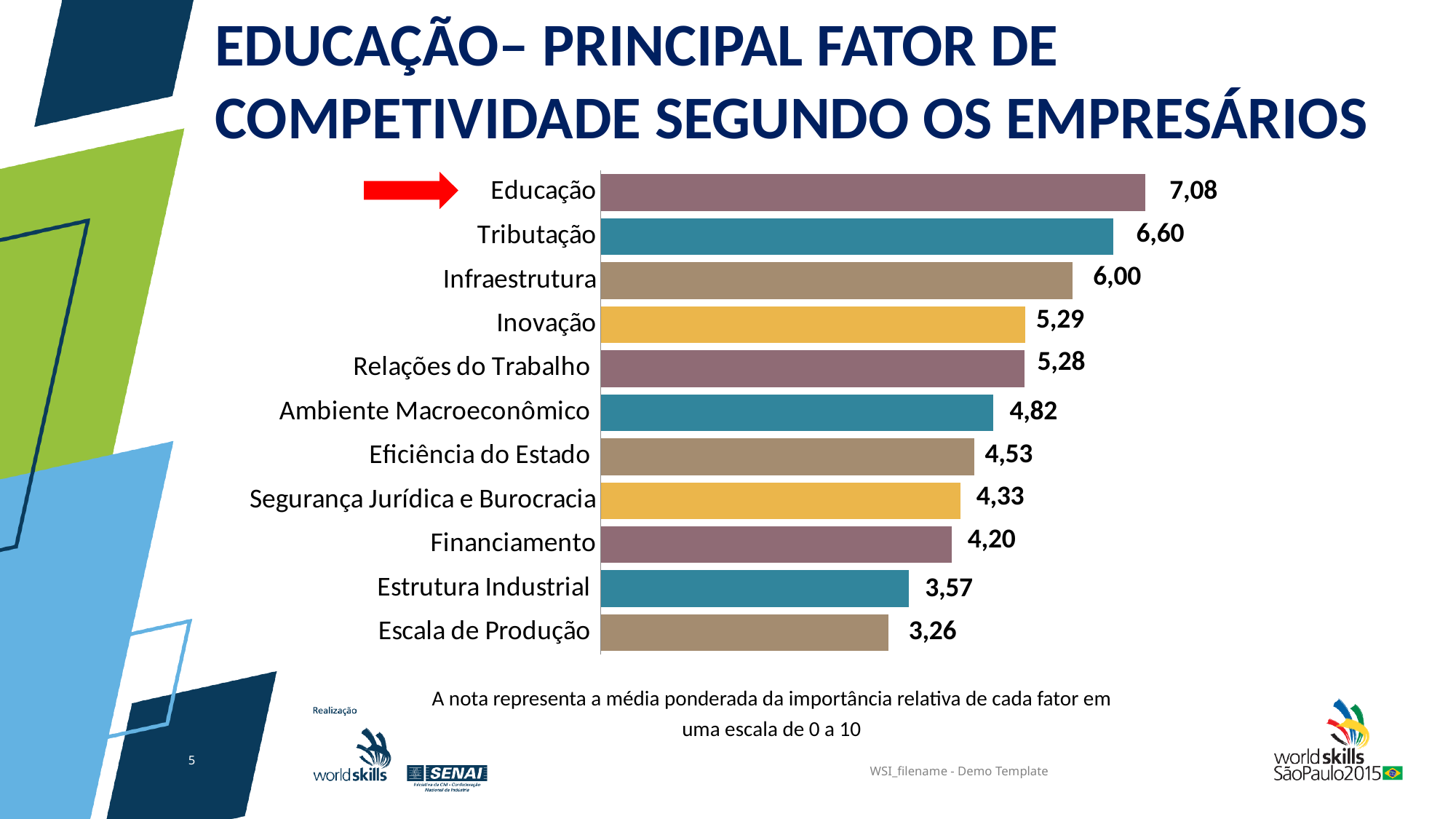
How many categories are shown in the chart? 11 Which is larger, the value for Eficiência do Estado or the value for Segurança Jurídica e Burocracia? Eficiência do Estado What is the value for Escala de Produção? 3,26 Which category has the highest value? Educação What is the value for Educação? 7,08 What is the difference between the values for Educação and Tributação? 0,48 What is the difference between the values for Infraestrutura and Financiamento? 1,80 What kind of chart is shown on the slide? Bar chart Which is larger, the value for Estrutura Industrial or the value for Financiamento? Financiamento What is the value for Ambiente Macroeconômico? 4,82 Which category has the lowest value? Escala de Produção Which category does the red arrow point to? Educação